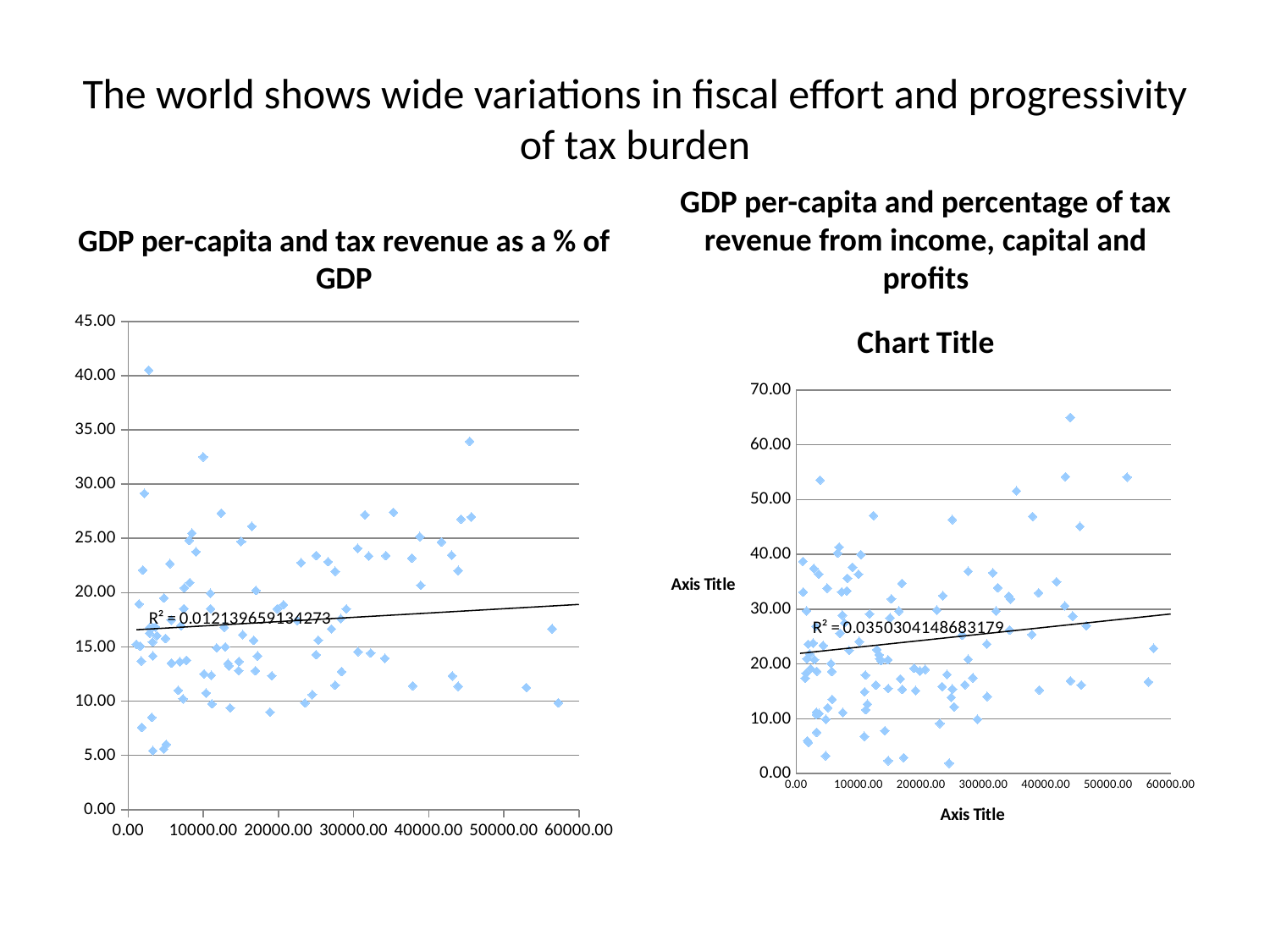
On the left chart, does the trendline rise or fall as GDP per-capita increases along the x axis? Rise How many charts are shown on the slide? 2 On the right chart, what is the highest value shown on the vertical axis? 70.00 On the right chart, what R² value is printed next to the trendline? R² = 0.0350304148683179 On the left chart, what R² value is printed next to the trendline? R² = 0.012139659134273 On the left chart, what is the highest value shown on the horizontal axis? 60000.00 On the left chart, is the highest plotted point greater or less than 35.00? greater What kind of chart is the left chart titled "GDP per-capita and tax revenue as a % of GDP"? Scatter chart On the right chart, is the highest plotted point greater or less than 60.00? greater On the left chart, what is the highest value shown on the vertical axis? 45.00 What kind of chart is the right chart labelled "Chart Title"? Scatter chart On the right chart, does the trendline rise or fall as GDP per-capita increases along the x axis? Rise